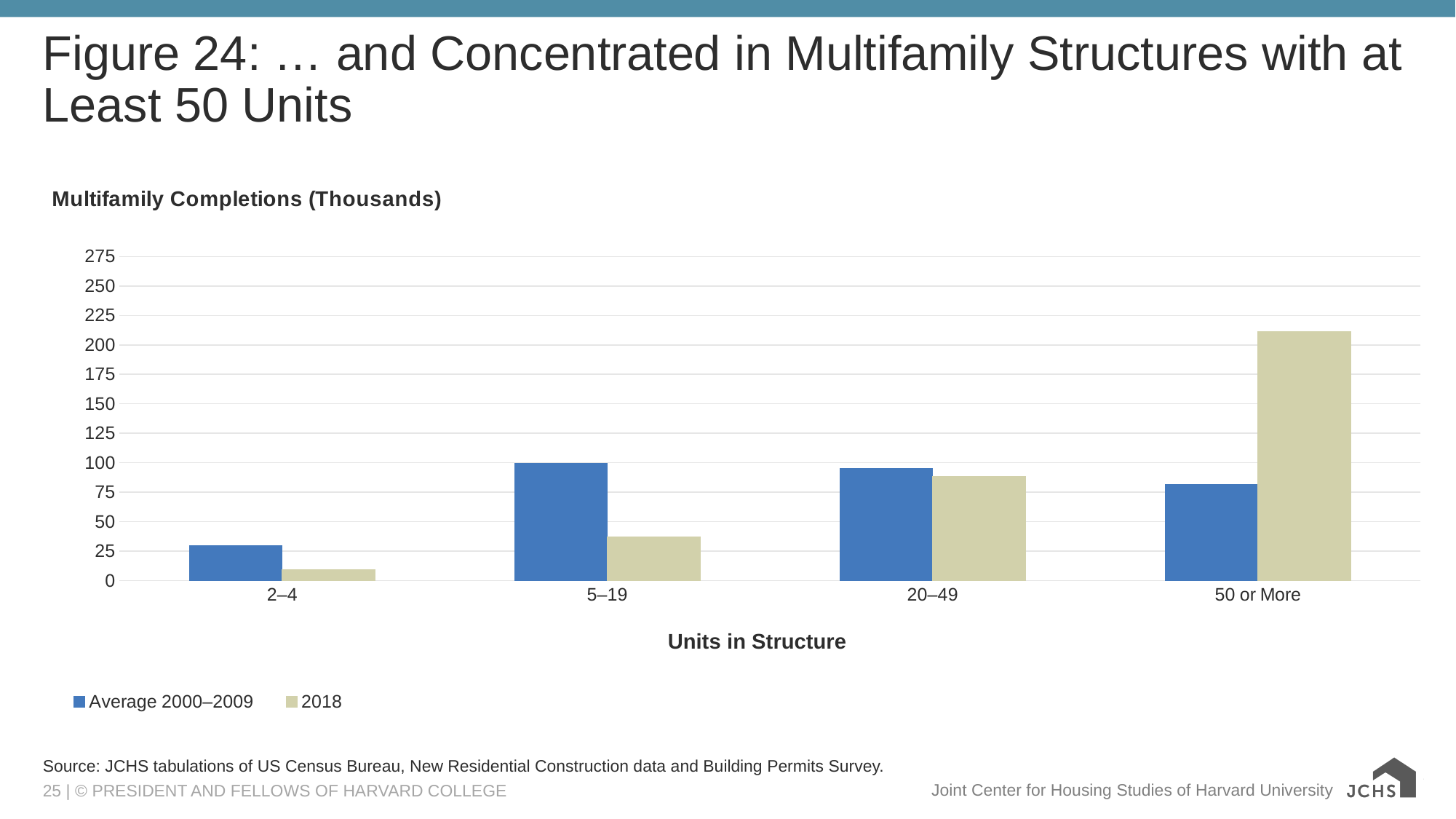
Is the 2018 value for 2–4 greater or less than 25? less Is the 2018 value for 50 or More greater or less than 200? greater Which category has the lowest value for the 2018 series? 2–4 For the 50 or More category, which series has the larger value: Average 2000–2009 or 2018? 2018 For the 5–19 category, which series has the larger value: Average 2000–2009 or 2018? Average 2000–2009 What kind of chart is shown on the slide? bar chart How many categories are shown on the x axis of the chart? 4 Which category has the lowest value for the Average 2000–2009 series? 2–4 Is the 2018 value for 5–19 greater or less than 50? less Which category has the highest value for the 2018 series? 50 or More How many series does the chart's legend list? 2